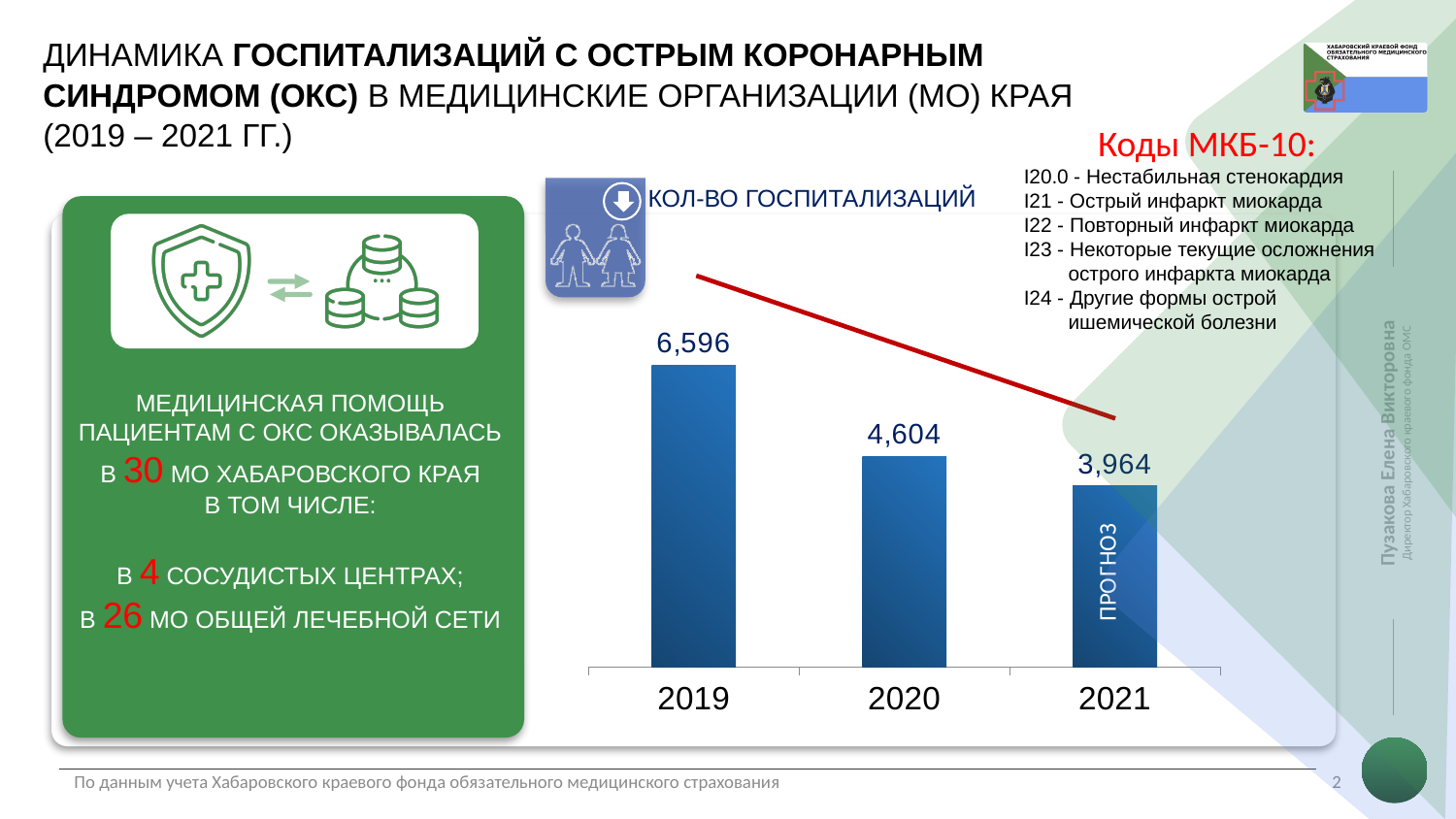
What kind of chart is used to show the number of hospitalizations? Bar chart Which year has more hospitalizations, 2020 or 2021? 2020 Which year's bar is labelled as a forecast (ПРОГНОЗ)? 2021 Which year has the lowest number of hospitalizations? 2021 What is the number of hospitalizations shown for 2020? 4,604 What is the difference in hospitalizations between 2020 and 2021? 640 What is the difference in hospitalizations between 2019 and 2020? 1,992 What is the number of hospitalizations shown for 2019? 6,596 How many years are shown on the chart? 3 Do the hospitalization values rise or fall from 2019 to 2021? Fall Which year has the highest number of hospitalizations? 2019 What is the number of hospitalizations shown for 2021? 3,964